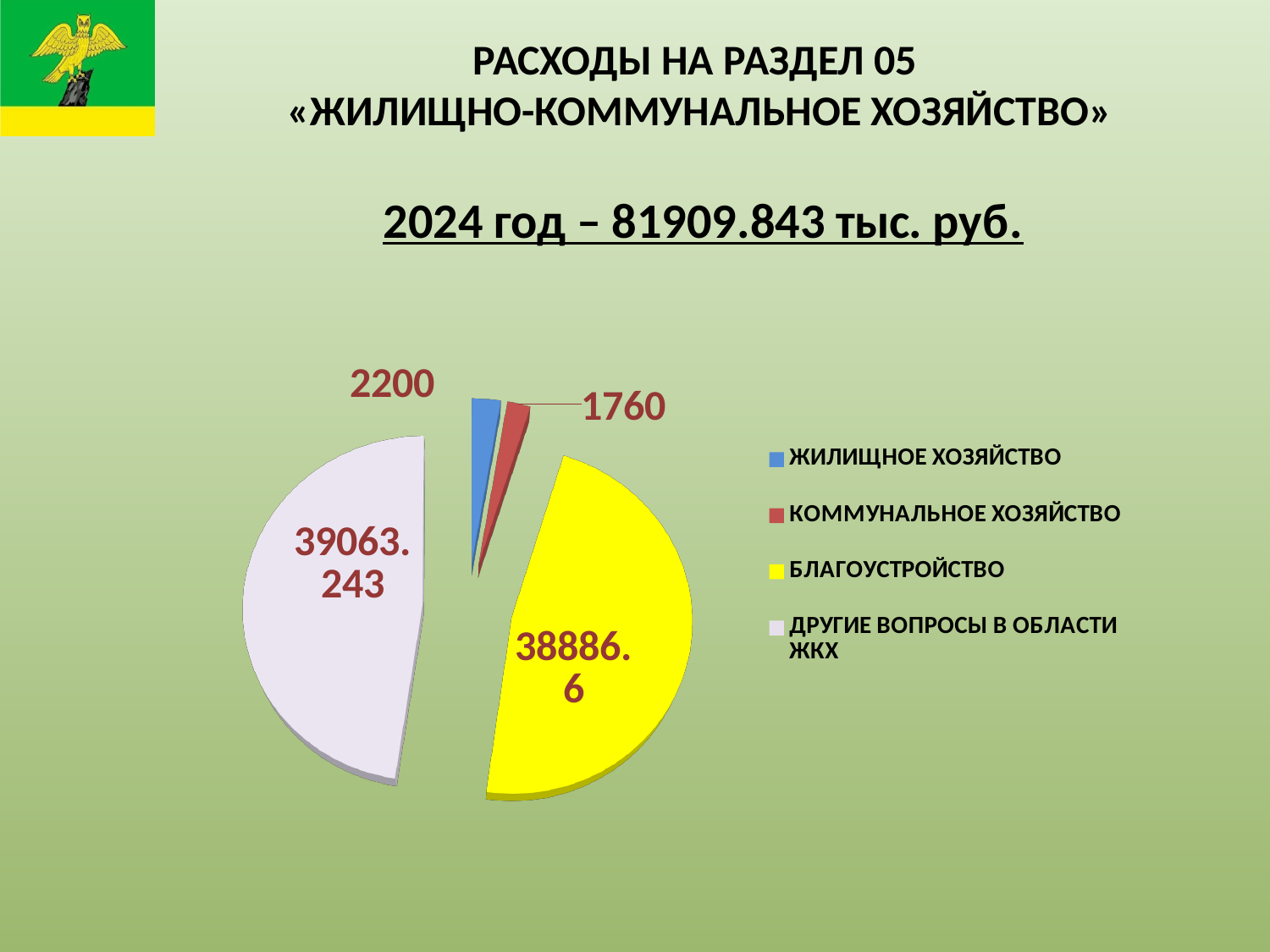
What is the difference between the values for ЖИЛИЩНОЕ ХОЗЯЙСТВО and КОММУНАЛЬНОЕ ХОЗЯЙСТВО? 440 Which category has the smallest value on the pie chart? КОММУНАЛЬНОЕ ХОЗЯЙСТВО Which is larger: the value for ЖИЛИЩНОЕ ХОЗЯЙСТВО or the value for КОММУНАЛЬНОЕ ХОЗЯЙСТВО? ЖИЛИЩНОЕ ХОЗЯЙСТВО What colour is the slice for БЛАГОУСТРОЙСТВО? Yellow What value is shown for ДРУГИЕ ВОПРОСЫ В ОБЛАСТИ ЖКХ on the pie chart? 39063.243 What value is shown for КОММУНАЛЬНОЕ ХОЗЯЙСТВО on the pie chart? 1760 Which category has the largest value on the pie chart? ДРУГИЕ ВОПРОСЫ В ОБЛАСТИ ЖКХ What value is shown for БЛАГОУСТРОЙСТВО on the pie chart? 38886.6 How many slices does the pie chart have? 4 What total amount for 2024 is stated above the chart? 81909.843 тыс. руб. What type of chart is shown on the slide? Pie chart What value is shown for ЖИЛИЩНОЕ ХОЗЯЙСТВО on the pie chart? 2200